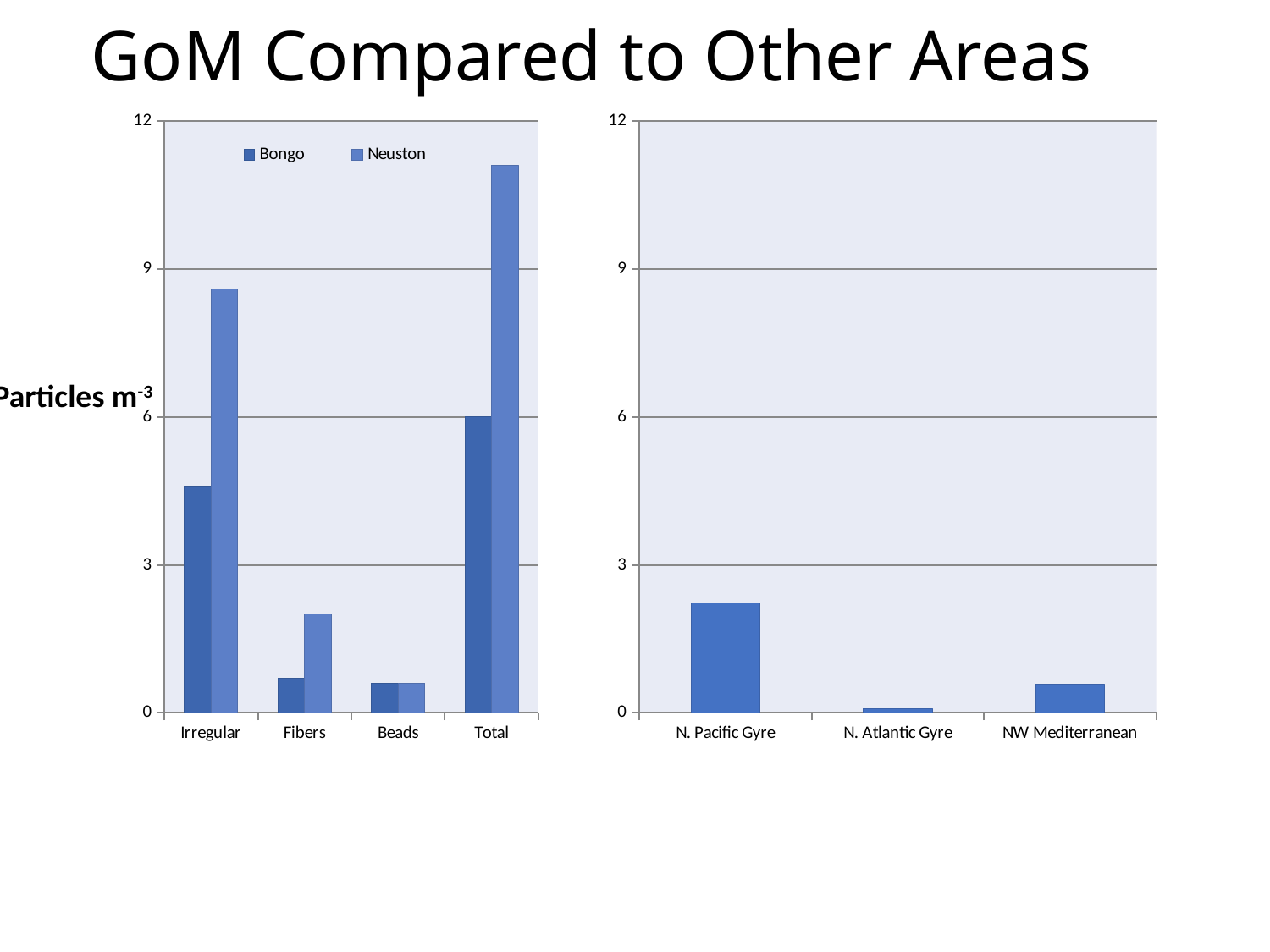
In the left chart, is the Neuston value for Total greater or less than 9? greater In the left chart, which category has the highest Neuston value? Total How many series does the legend of the left chart list? 2 What kind of chart is the left chart on the slide? bar chart How many categories are shown on the x axis of the right chart? 3 In the left chart, is the Bongo value for Irregular greater or less than 3? greater How many categories are shown on the x axis of the left chart? 4 In the left chart, is the Neuston value for Irregular greater or less than 6? greater In the right chart, which category has the highest value? N. Pacific Gyre In the left chart, which series has the larger value for Fibers, Bongo or Neuston? Neuston What are the two series named in the legend of the left chart? Bongo and Neuston